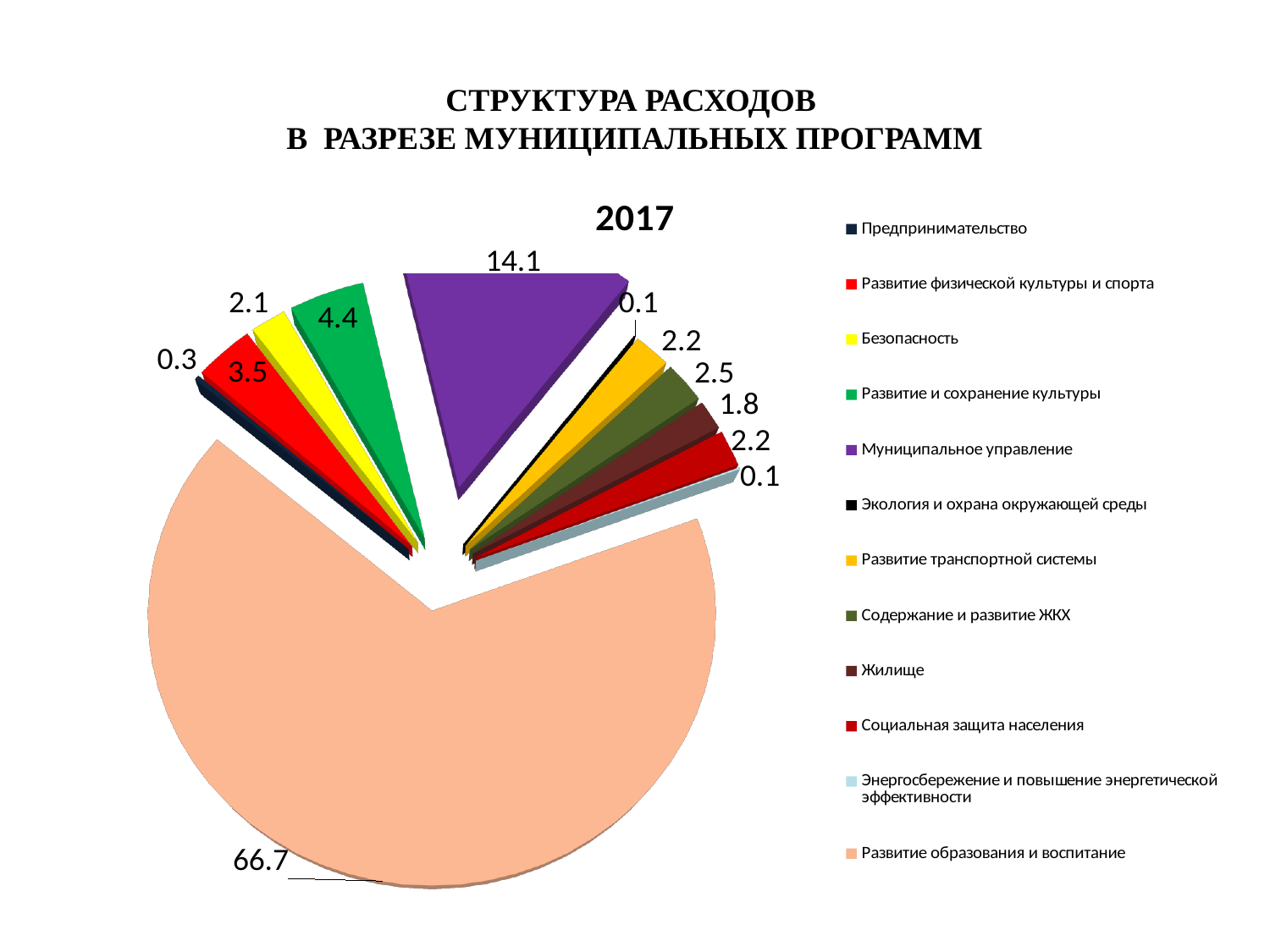
Which is larger: Развитие физической культуры и спорта or Безопасность? Развитие физической культуры и спорта Which category has the largest slice of the pie? Развитие образования и воспитание What year is shown as the chart's title? 2017 What is the value for Развитие и сохранение культуры? 4.4 What is the value for Развитие физической культуры и спорта? 3.5 What is the difference between the values for Муниципальное управление and Развитие и сохранение культуры? 9.7 What colour is the slice for Муниципальное управление? purple What is the value for Развитие образования и воспитание? 66.7 What is the value for Жилище? 1.8 How many categories does the legend list? 12 What is the value for Муниципальное управление? 14.1 What kind of chart is shown on the slide? pie chart